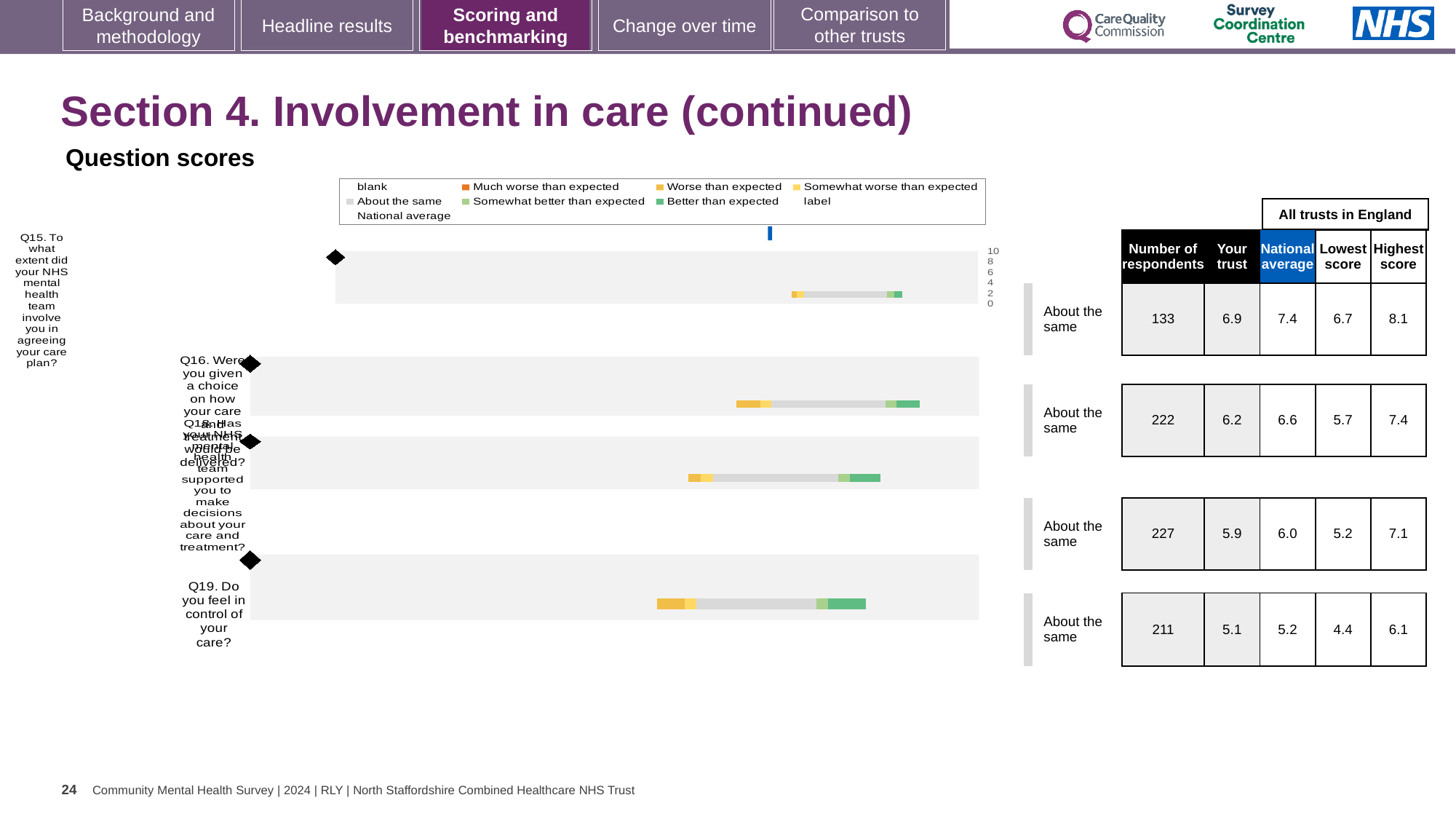
What benchmark category is shown for each of the four questions on this slide? About the same What kind of chart is used to show the question scores on this slide? bar chart What is the national average score for Q16 (choice on how care and treatment would be delivered)? 6.6 Which question has the lowest national average score? Q19 How many respondents answered Q19 (feeling in control of your care)? 211 For Q18, what is the difference between the highest score and the lowest score among all trusts in England? 1.9 For Q16, which is larger: the 'Your trust' score or the national average? National average How many questions are plotted in the question scores chart? 4 Which question has the highest 'Your trust' score? Q15 What is the 'Your trust' score for Q15 (involvement in agreeing your care plan)? 6.9 What is the lowest score among all trusts in England for Q15? 6.7 For Q19, how much higher is the national average than the 'Your trust' score? 0.1